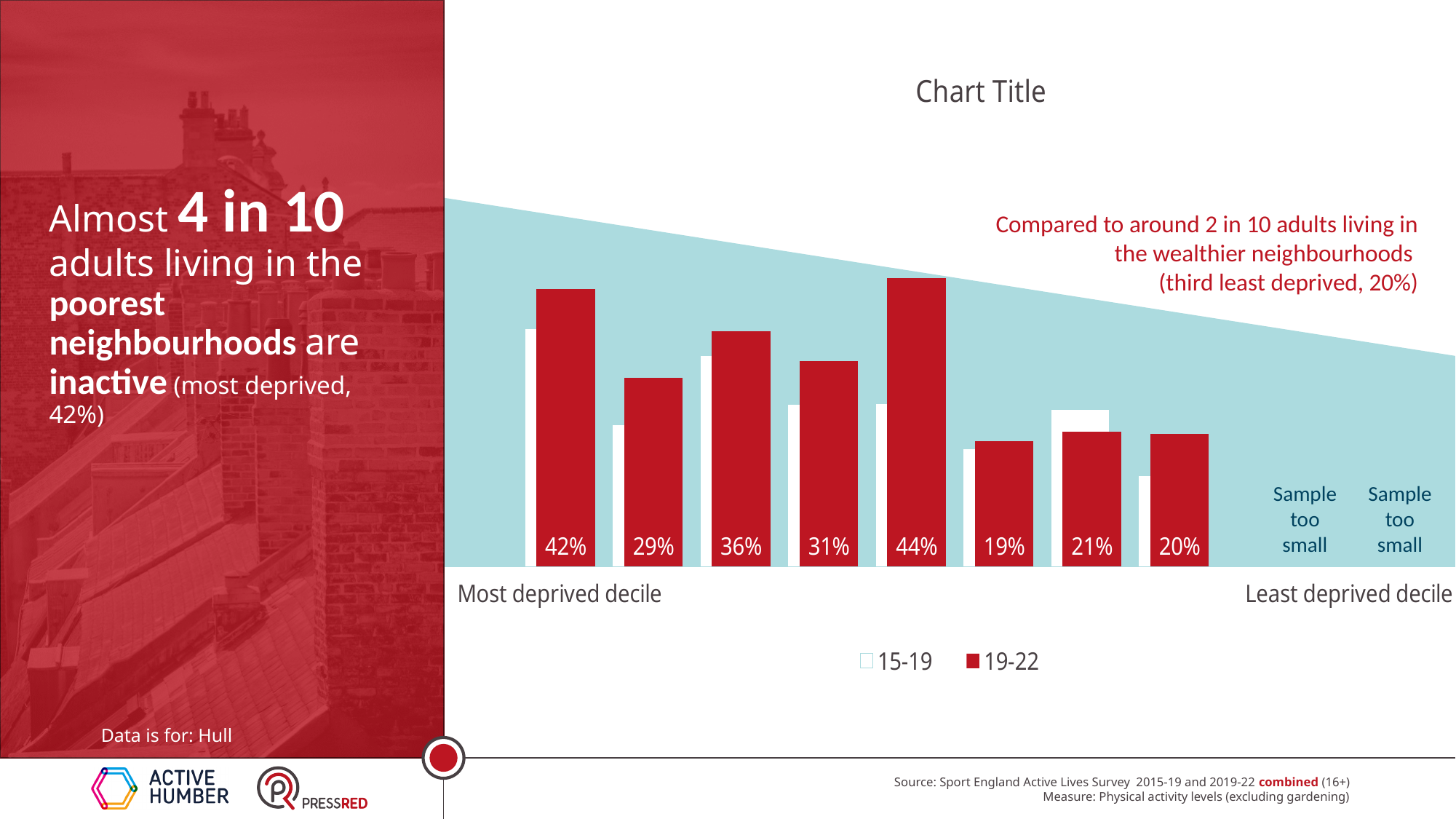
What are the two series named in the chart legend? 15-19 and 19-22 Which labelled 19-22 bar has the highest value? the fifth bar, 44% What kind of chart is shown on the slide? bar chart Which is larger, the 19-22 value for the first bar or the second bar? the first bar (42%) What is the 19-22 value for the second bar from the left? 29% What is the 19-22 value for the fifth bar from the left? 44% How many series does the chart legend list? 2 Which labelled 19-22 bar has the lowest value? the sixth bar, 19% What is the 19-22 value for the third least deprived decile (the last labelled bar)? 20% What is the difference between the 19-22 value for the most deprived decile (42%) and the third least deprived decile (20%)? 22 percentage points What is the 19-22 value for the most deprived decile (the first bar)? 42% How many deciles are marked as 'Sample too small' on the chart? 2